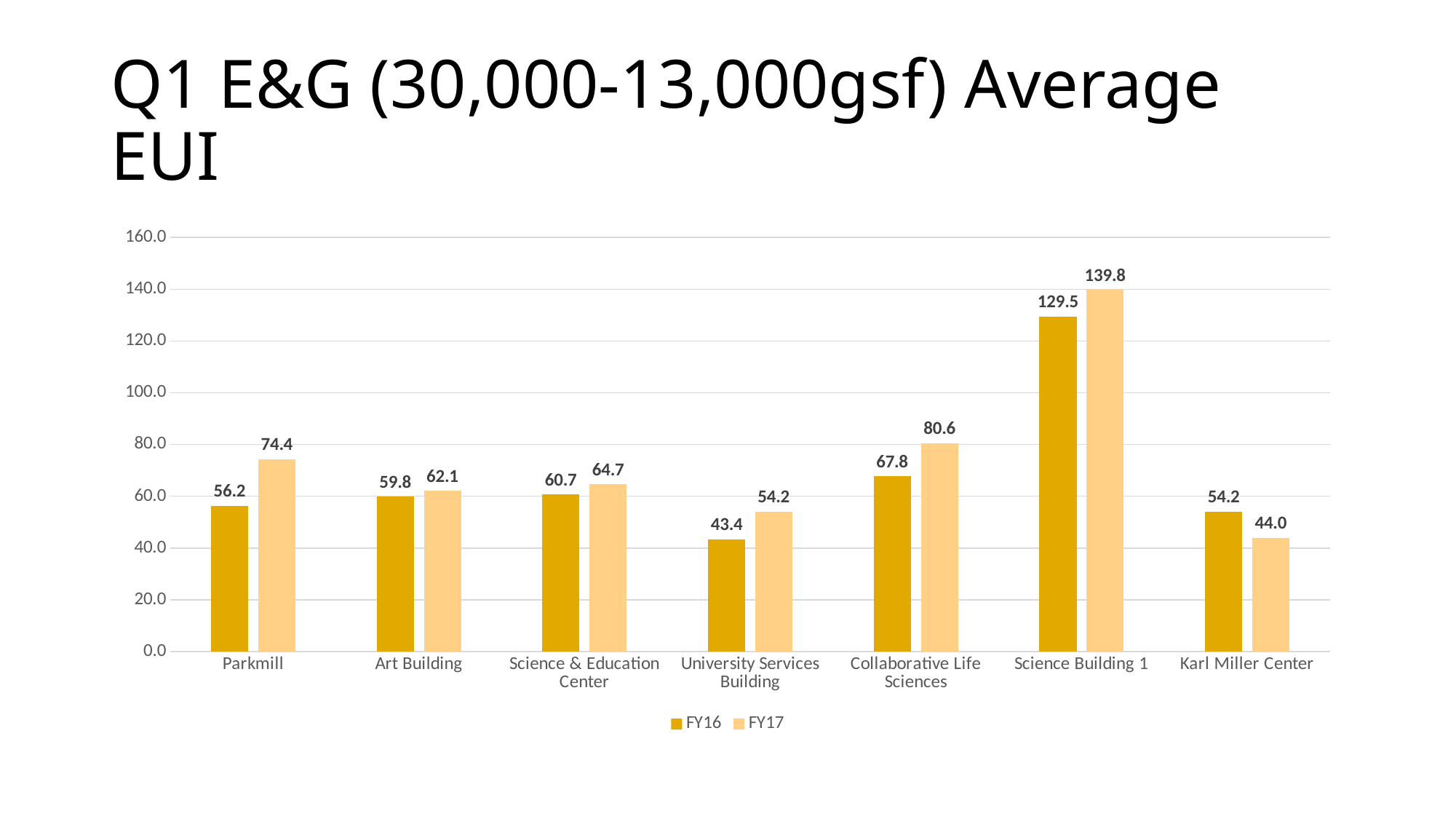
Which is larger for Karl Miller Center, the FY16 value or the FY17 value? FY16 What is the FY17 value for Parkmill? 74.4 What kind of chart is shown on the slide? Bar chart How many series does the legend list? 2 What is the FY16 value for University Services Building? 43.4 Which building has the lowest FY17 value? Karl Miller Center Which building has the highest FY16 value? Science Building 1 What is the FY17 value for Science Building 1? 139.8 Is the FY16 value for Science Building 1 greater or less than 120.0? greater What is the difference between the FY17 and FY16 values for Collaborative Life Sciences? 12.8 How many buildings are shown on the x axis? 7 What are the two series named in the legend? FY16 and FY17